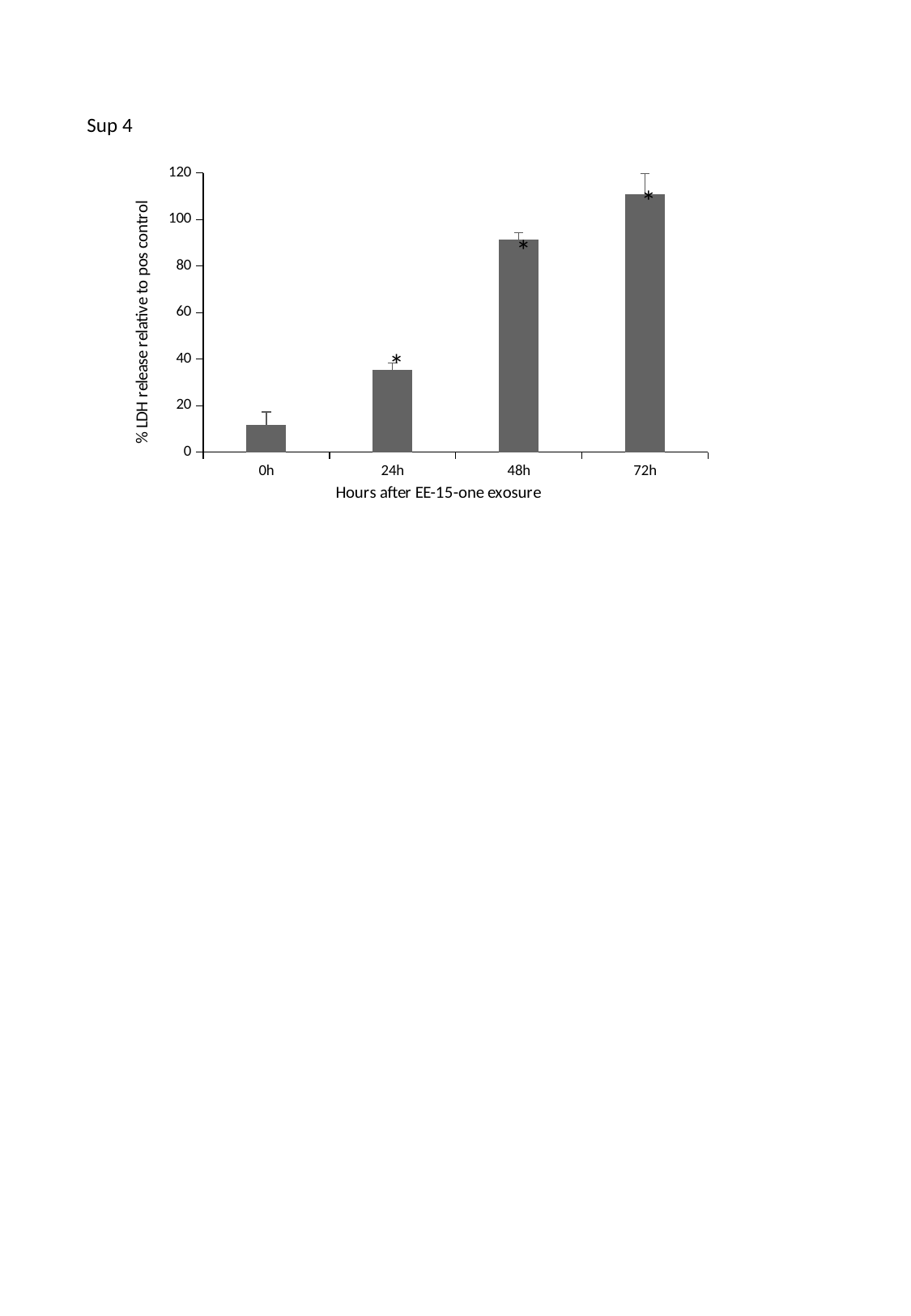
What is the label of the y axis? % LDH release relative to pos control Which time point has the lowest % LDH release? 0h Is the value for 72h greater or less than 100? greater What is the label of the x axis? Hours after EE-15-one exosure Is the value for 48h greater or less than 80? greater How many time-point categories are plotted on the x axis? 4 Do the values rise or fall as hours after exposure increase along the x axis? rise What kind of chart is shown on the slide? bar chart Which time point has the highest % LDH release? 72h Is the value for 24h greater or less than 40? less Which is larger, the value for 24h or the value for 48h? 48h